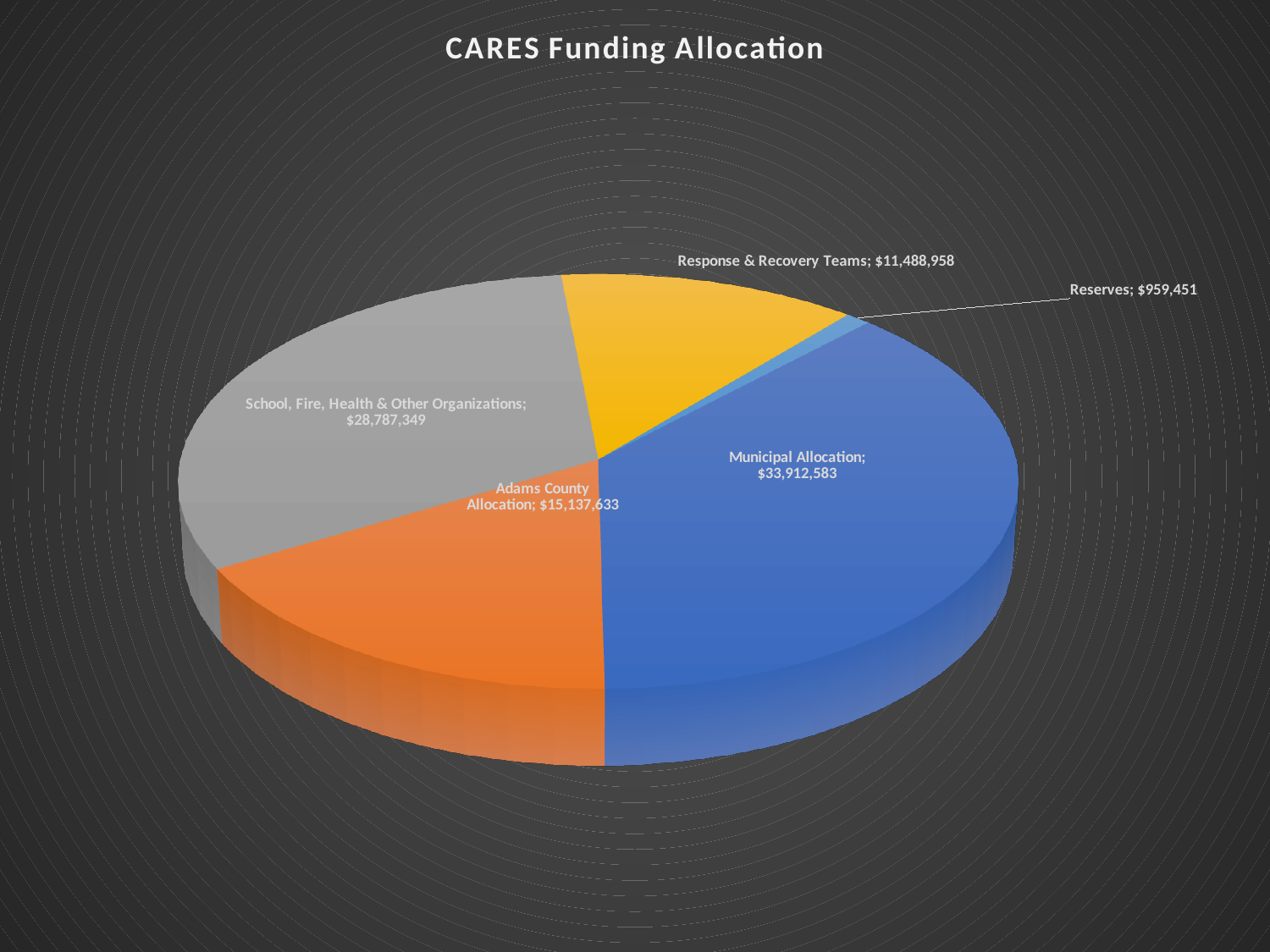
Which category has the largest allocation? Municipal Allocation What is the value for Reserves? $959,451 Which is larger, Adams County Allocation or Response & Recovery Teams? Adams County Allocation What is the value for Response & Recovery Teams? $11,488,958 What is the value for Municipal Allocation? $33,912,583 What is the difference between Municipal Allocation and School, Fire, Health & Other Organizations? $5,125,234 What is the difference between Adams County Allocation and Response & Recovery Teams? $3,648,675 What kind of chart is shown on the slide? Pie chart How many slices does the pie chart have? 5 What is the value for School, Fire, Health & Other Organizations? $28,787,349 What is the title of the chart? CARES Funding Allocation Which category has the smallest allocation? Reserves